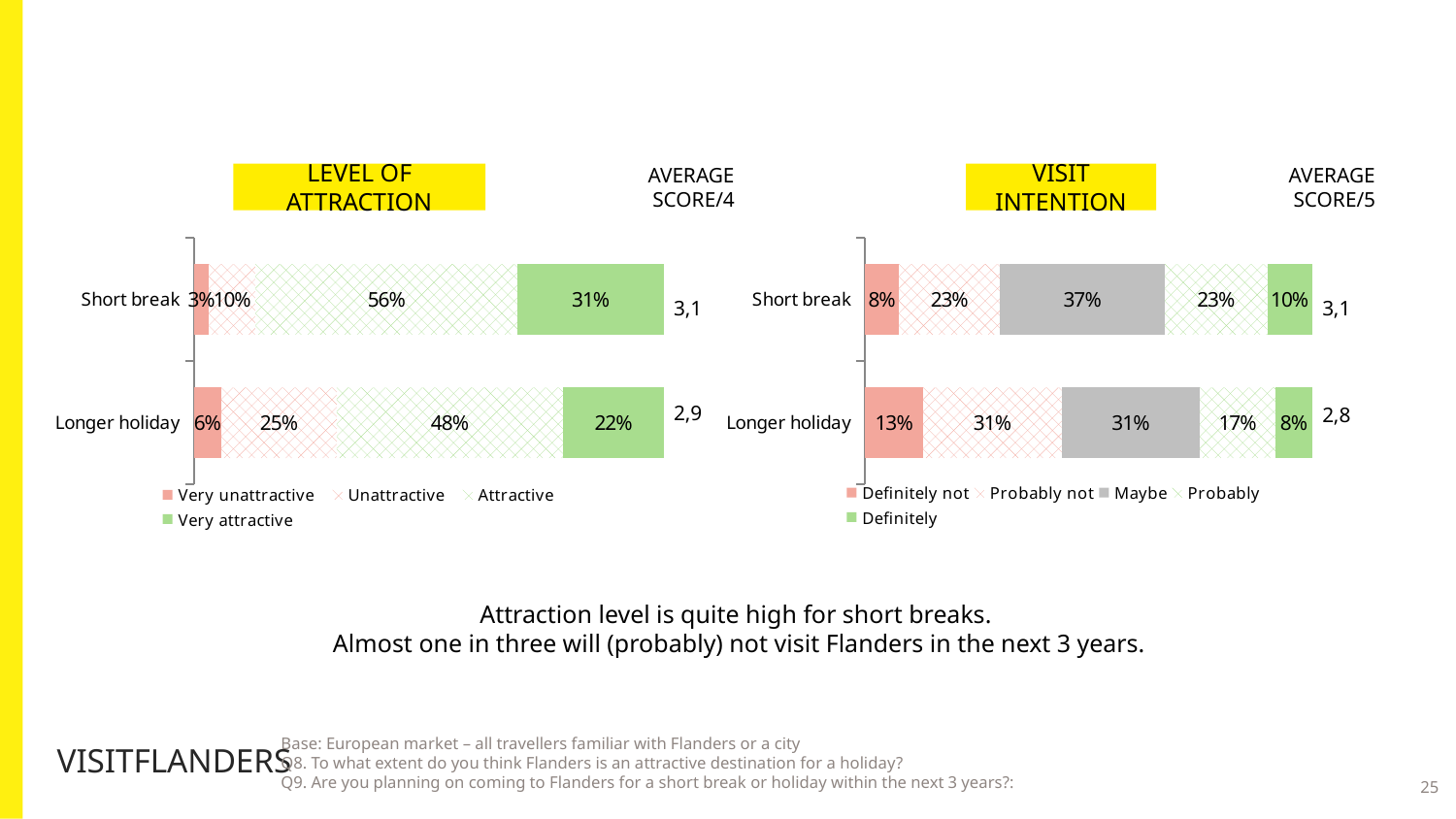
In the VISIT INTENTION chart, which category has the larger Definitely share, Short break or Longer holiday? Short break In the VISIT INTENTION chart, what percentage of Longer holiday respondents answered Definitely not? 13% How many series does the legend of the LEVEL OF ATTRACTION chart list? 4 In the LEVEL OF ATTRACTION chart, what is the difference between the Attractive shares for Short break and Longer holiday? 8% In the VISIT INTENTION chart, which category has the higher average score, Short break or Longer holiday? Short break What kind of chart is the LEVEL OF ATTRACTION chart? Stacked bar chart How many series does the legend of the VISIT INTENTION chart list? 5 In the LEVEL OF ATTRACTION chart, what is the average score for Longer holiday? 2,9 In the VISIT INTENTION chart, what is the combined share of Definitely not and Probably not for Longer holiday? 44% In the LEVEL OF ATTRACTION chart, what percentage of Short break respondents find Flanders very attractive? 31% In the VISIT INTENTION chart, what percentage of Short break respondents answered Maybe? 37% In the LEVEL OF ATTRACTION chart, what percentage of Longer holiday respondents find Flanders attractive? 48%